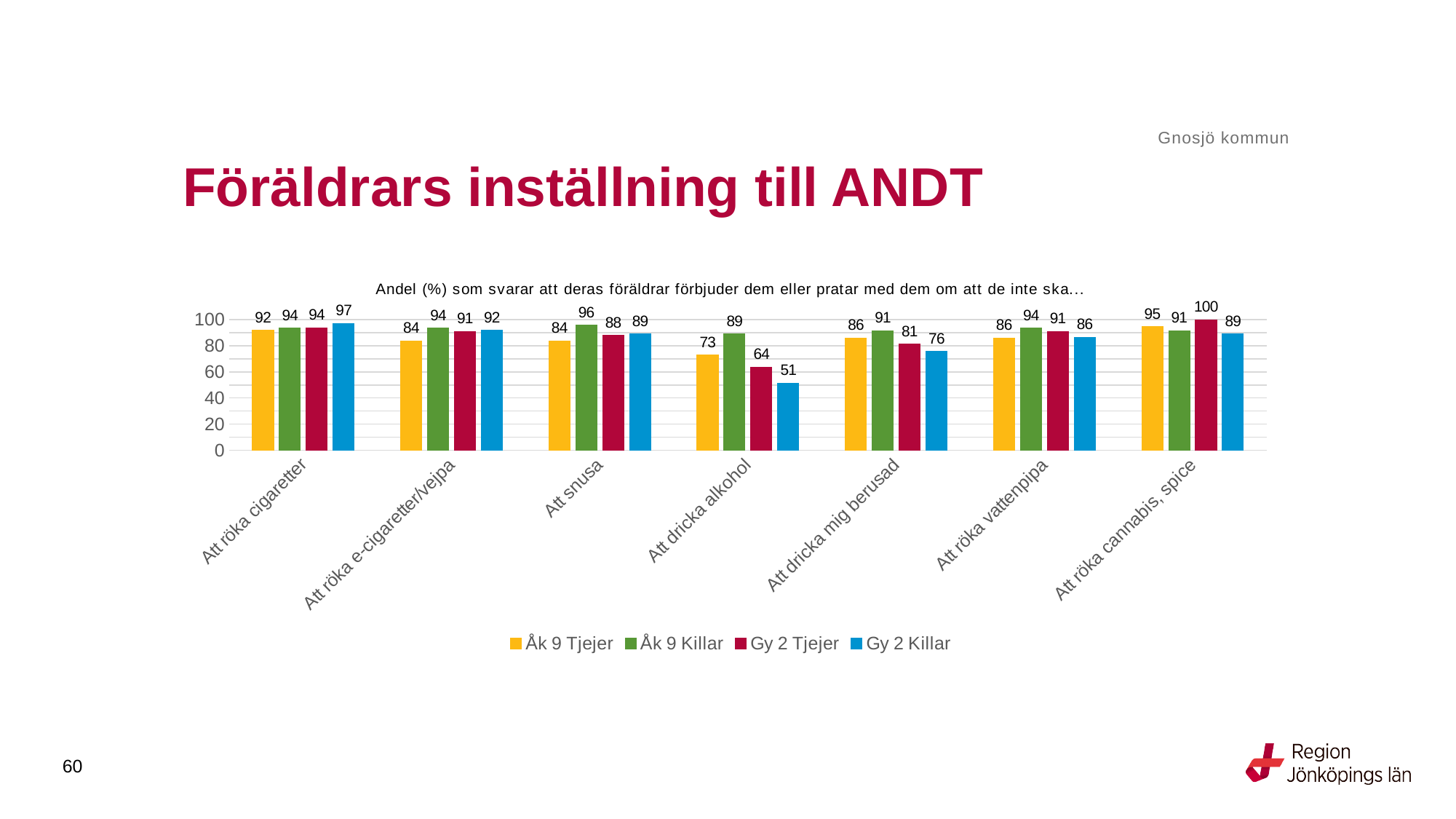
How many categories are shown on the x axis? 7 What is the value for Åk 9 Tjejer in the category 'Att röka e-cigaretter/vejpa'? 84 Which category has the highest value for Gy 2 Tjejer? Att röka cannabis, spice What is the value for Åk 9 Killar in the category 'Att snusa'? 96 What kind of chart is shown on the slide? bar chart What is the value for Gy 2 Tjejer in the category 'Att röka cannabis, spice'? 100 In the category 'Att dricka mig berusad', which is larger: Åk 9 Tjejer or Gy 2 Tjejer? Åk 9 Tjejer What is the difference between Åk 9 Killar and Gy 2 Killar in the category 'Att dricka alkohol'? 38 What is the value for Gy 2 Killar in the category 'Att dricka alkohol'? 51 How many series does the legend list? 4 Which category has the lowest value for Gy 2 Killar? Att dricka alkohol Is the value for Gy 2 Tjejer in 'Att dricka alkohol' greater or less than 80? less